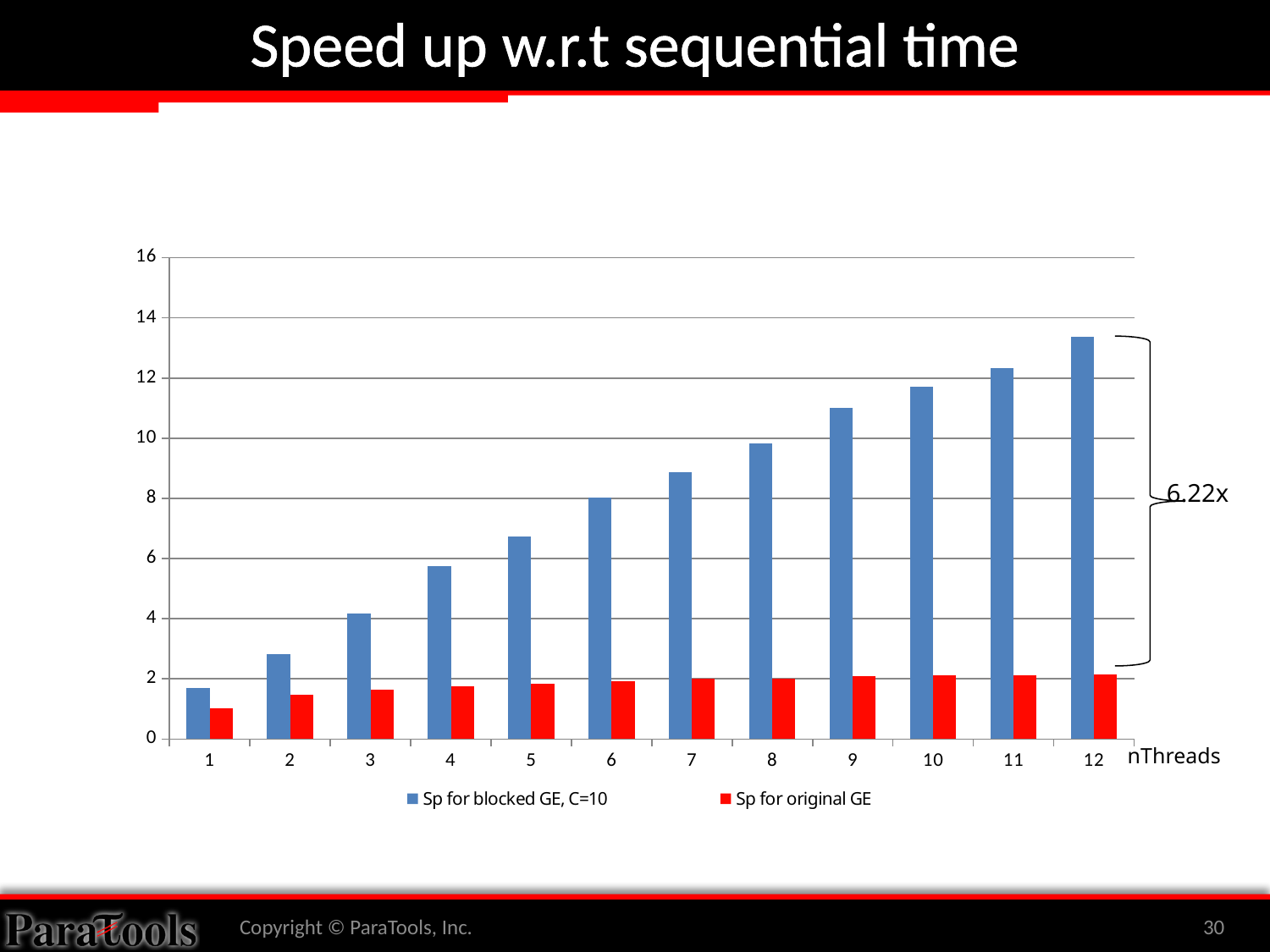
At which number of threads is the speedup for blocked GE, C=10 highest? 12 Does the speedup for blocked GE, C=10 rise or fall as the number of threads increases? rise What label is shown on the x axis of the chart? nThreads Is the speedup for blocked GE, C=10 at 9 threads greater or less than 10? greater Is the speedup for blocked GE, C=10 at 12 threads greater or less than 12? greater How many series does the legend list? 2 How many thread counts (categories) are plotted along the x axis? 12 At 6 threads, which series has the larger speedup: blocked GE, C=10 or original GE? Sp for blocked GE, C=10 At which number of threads is the speedup for blocked GE, C=10 lowest? 1 What kind of chart is shown on the slide? bar chart Is the speedup for original GE at 1 thread greater or less than 2? less At which number of threads is the speedup for original GE lowest? 1